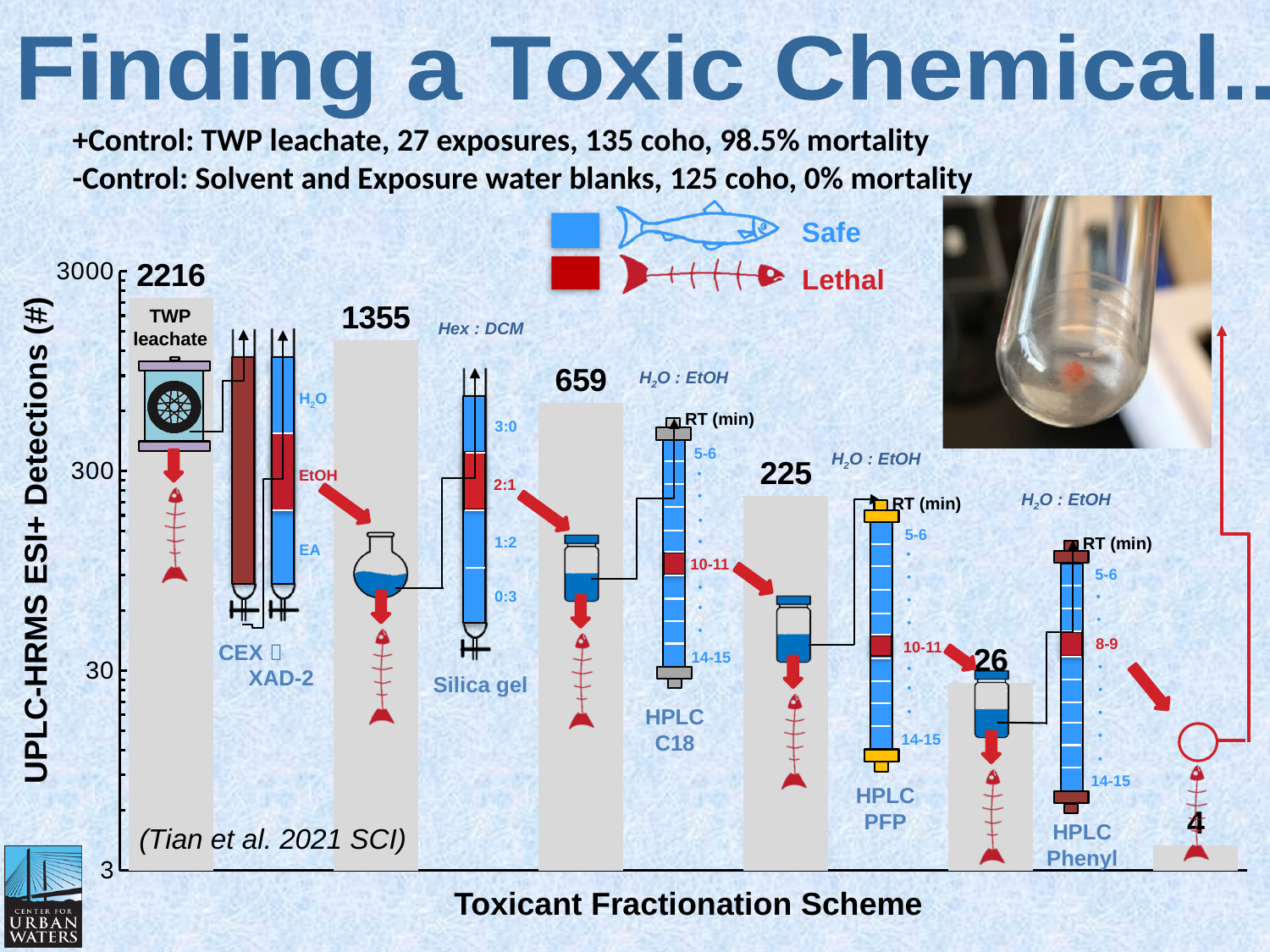
What is the title of the y axis of the chart? UPLC-HRMS ESI+ Detections (#) Do the bar values rise or fall from left to right along the x axis? fall What is the number of UPLC-HRMS ESI+ detections for the TWP leachate bar? 2216 What is the value of the second bar from the left in the chart? 1355 Which bar has the highest number of detections? TWP leachate (2216) How many bars are plotted in the chart? 6 Is the value of the bar labelled 26 greater or less than 30? less What kind of chart is shown on the slide? bar chart What is the lowest value plotted in the chart? 4 Which is larger, the bar labelled 659 or the bar labelled 225? 659 What is the difference between the first bar (2216) and the second bar (1355)? 861 What is the value of the last (rightmost) bar in the chart? 4